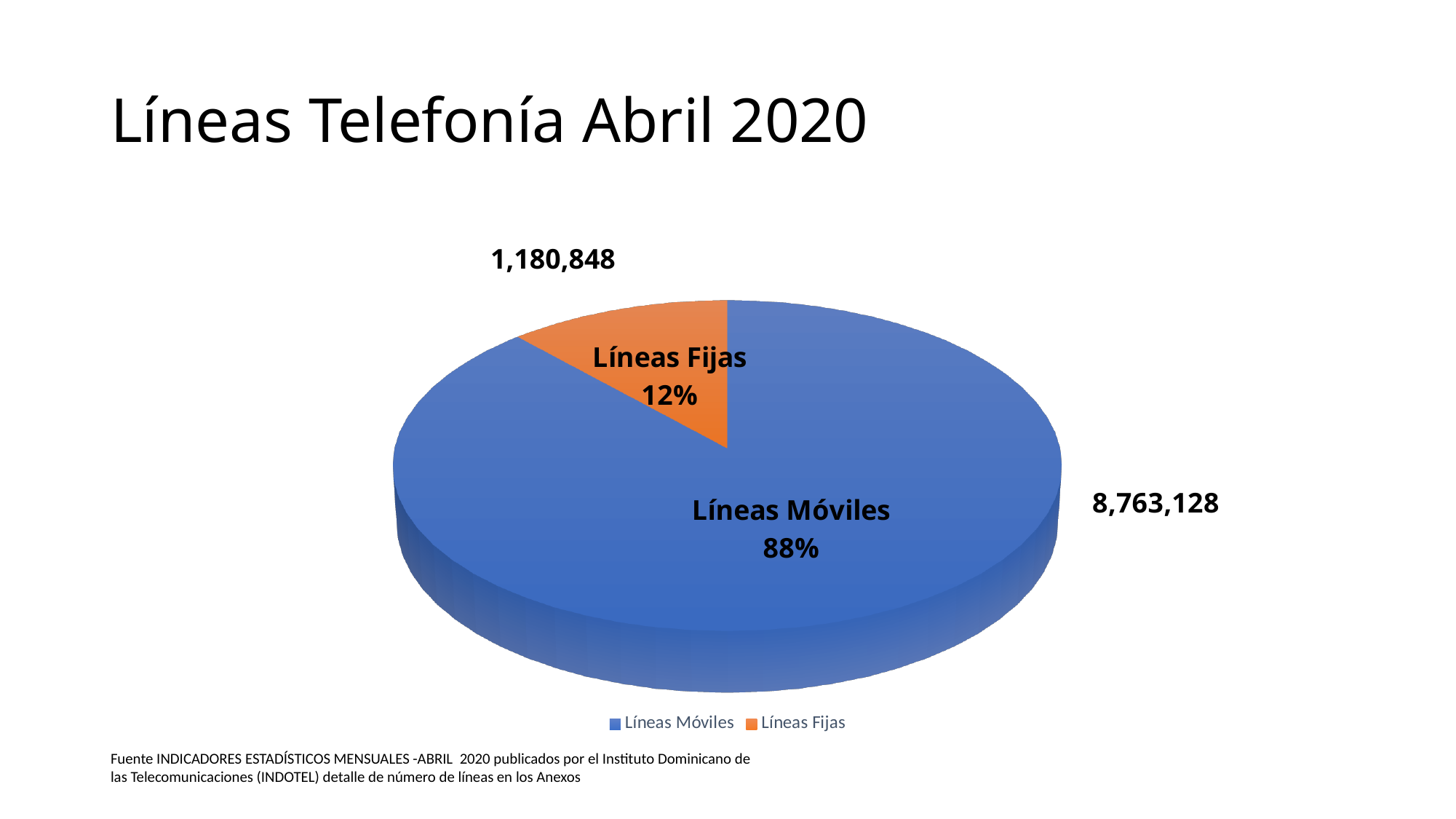
Which is larger, Líneas Móviles or Líneas Fijas? Líneas Móviles What colour is the Líneas Fijas slice? Orange What is the value for Líneas Fijas? 1,180,848 What is the value for Líneas Móviles? 8,763,128 What kind of chart is shown on the slide? Pie chart What share of the pie does Líneas Fijas represent? 12% How many slices does the pie chart have? 2 What share of the pie does Líneas Móviles represent? 88% What is the difference between the values for Líneas Móviles and Líneas Fijas? 7,582,280 Which category has the smallest slice? Líneas Fijas Which category has the largest slice? Líneas Móviles How many entries does the legend list? 2